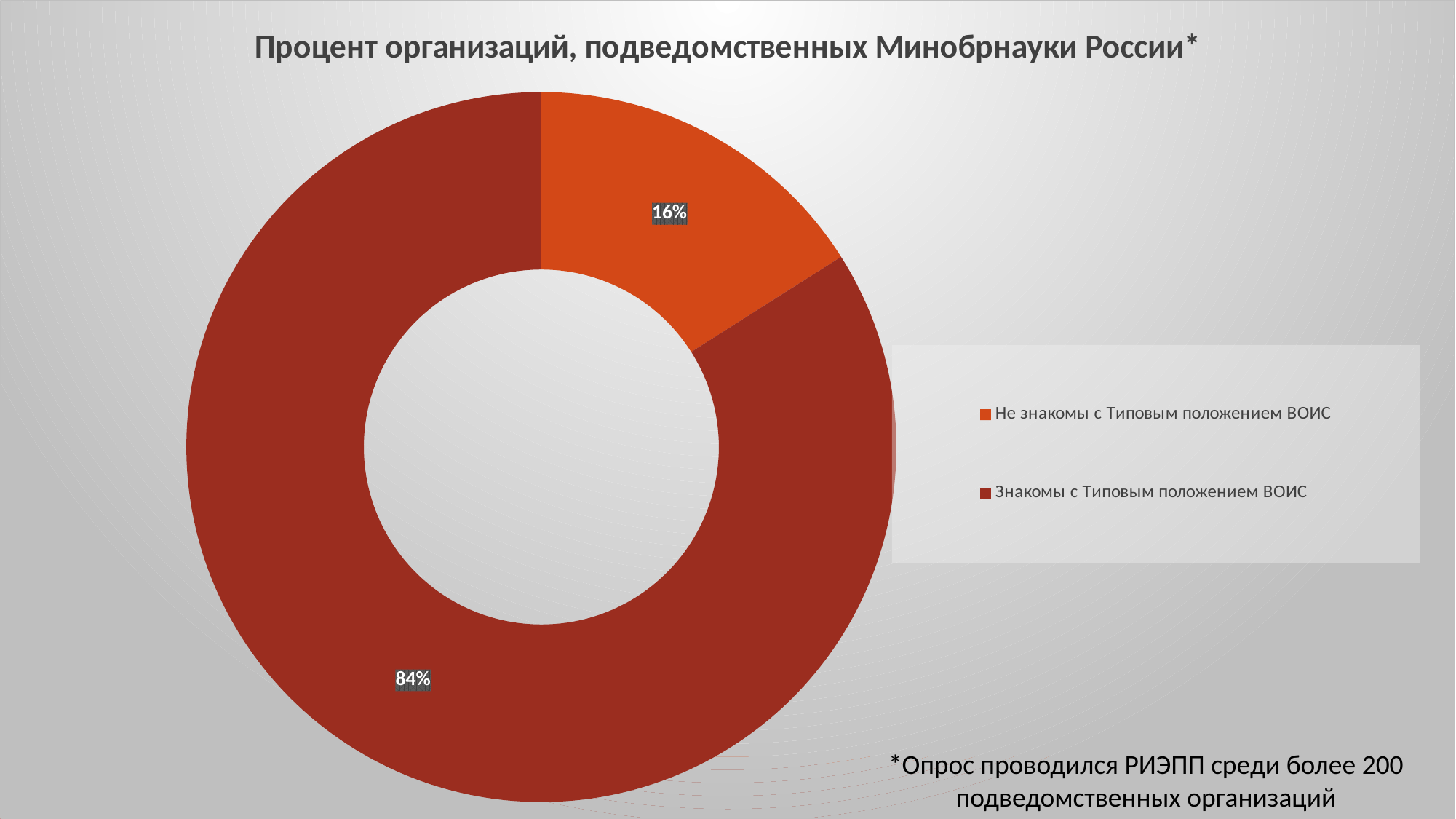
Which colour represents 'Не знакомы с Типовым положением ВОИС' in the legend? Orange What kind of chart is shown on the slide? Doughnut (pie) chart What percentage of organisations are labelled 'Не знакомы с Типовым положением ВОИС'? 16% How many entries does the legend list? 2 Which is larger: the share of organisations familiar with the WIPO model provision or the share not familiar with it? Знакомы с Типовым положением ВОИС What is the title of the chart? Процент организаций, подведомственных Минобрнауки России* Which category has the largest share of the chart? Знакомы с Типовым положением ВОИС Which category has the smallest share of the chart? Не знакомы с Типовым положением ВОИС How many categories does the chart show? 2 What is the difference in percentage points between the 'Знакомы' and 'Не знакомы' slices? 68 What share of the whole does the 'Не знакомы с Типовым положением ВОИС' slice represent? 16% What percentage of organisations are labelled 'Знакомы с Типовым положением ВОИС'? 84%